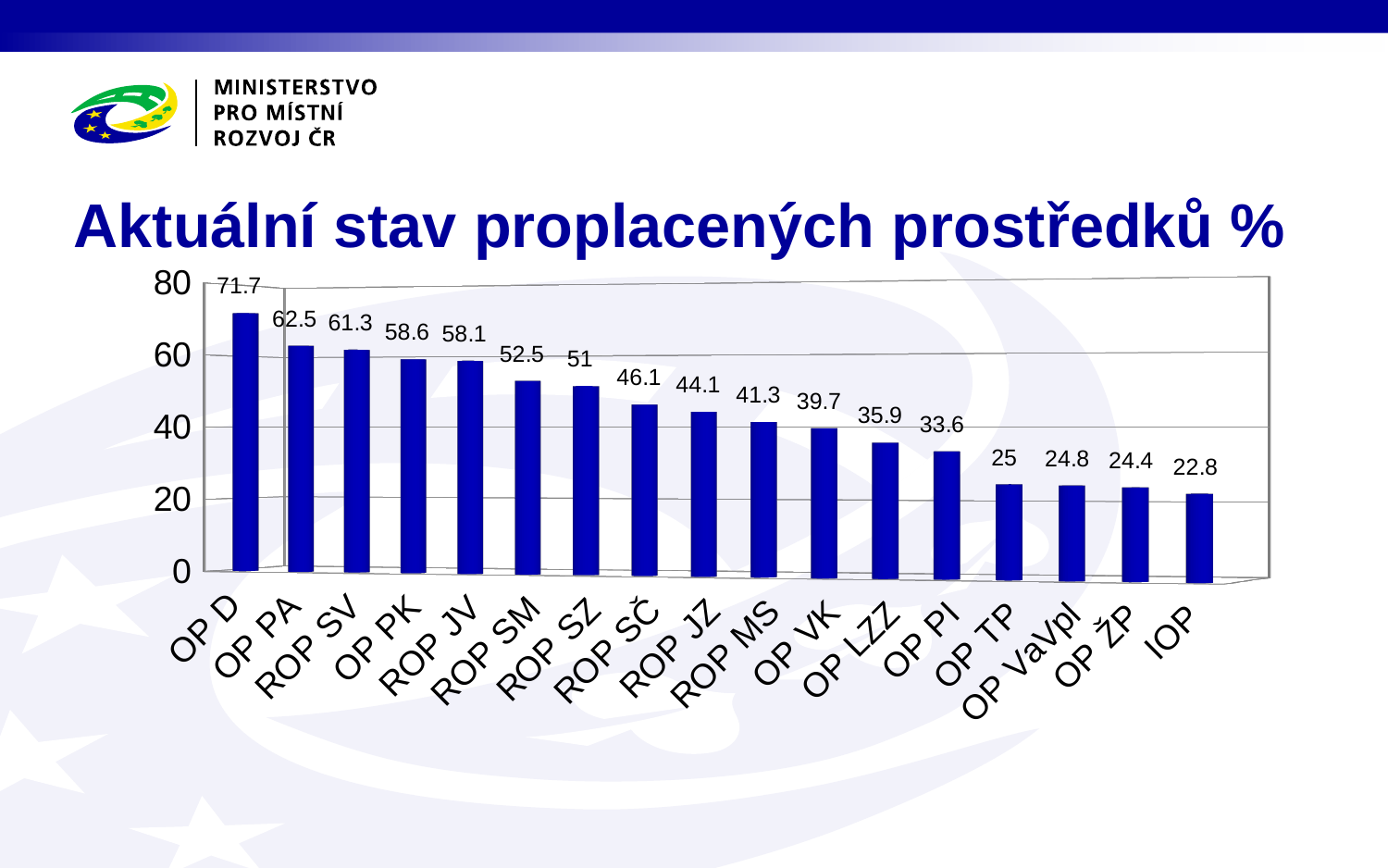
Which category has the highest value? OP D Which is larger, the value for ROP SM or the value for ROP JZ? ROP SM Which category has the lowest value? IOP What is the difference between the values for OP D and IOP? 48.9 What kind of chart is shown on the slide? Bar chart What is the value for OP D? 71.7 What is the difference between the values for OP PA and ROP SV? 1.2 Do the values rise or fall from left to right along the x axis? Fall What is the value for OP LZZ? 35.9 How many categories are shown on the x axis? 17 What is the value for IOP? 22.8 What is the value for ROP SZ? 51